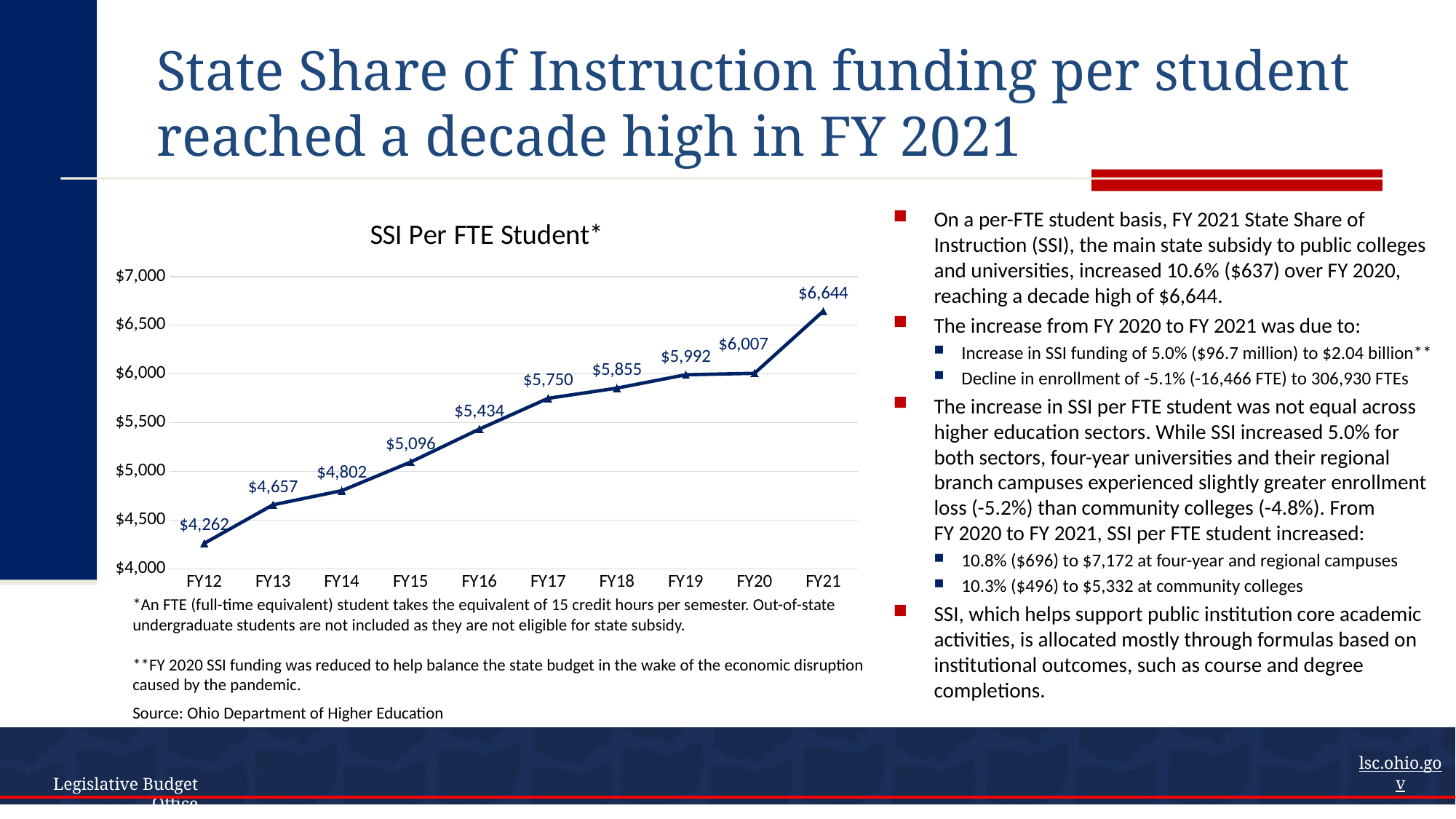
Is the value for FY19 greater or less than $6,000? less What is the SSI per FTE student value for FY16? $5,434 What is the SSI per FTE student value for FY12? $4,262 What is the difference between the FY13 and FY12 values? $395 What is the SSI per FTE student value for FY21? $6,644 Do the values rise or fall from FY12 to FY21? rise Which fiscal year has the highest SSI per FTE student? FY21 Which is larger, the value for FY17 or the value for FY15? FY17 How many fiscal years are plotted on the chart? 10 Which fiscal year has the lowest SSI per FTE student? FY12 What kind of chart is shown on the slide? line chart What is the difference between the FY21 and FY20 values? $637